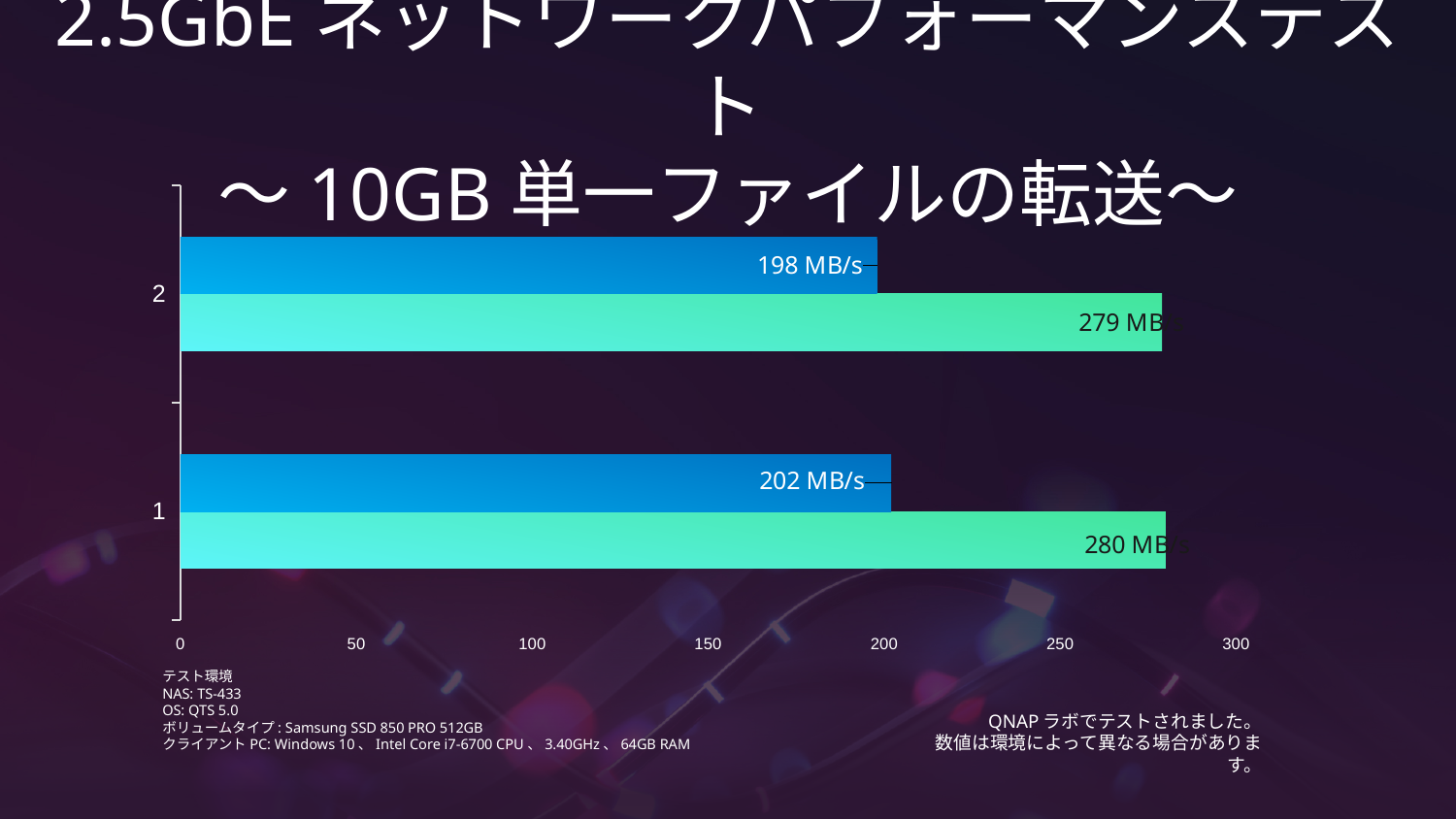
How many categories are shown on the vertical axis of the chart? 2 What is the maximum value shown on the horizontal axis of the chart? 300 What type of chart is shown on the slide? bar chart Is the value of the green bar for category 2 greater or less than 250? greater What is the value of the blue bar for category 2? 198 MB/s Is the value of the blue bar for category 2 greater or less than 200? less Which category has the higher value for the blue bar, 1 or 2? 1 What is the value of the blue bar for category 1? 202 MB/s Is the value of the green bar for category 1 greater or less than 300? less For category 1, which bar is larger, the blue bar or the green bar? the green bar What two colours are used for the bars in the chart? blue and green What is the difference between the blue bar values for category 1 and category 2? 4 MB/s